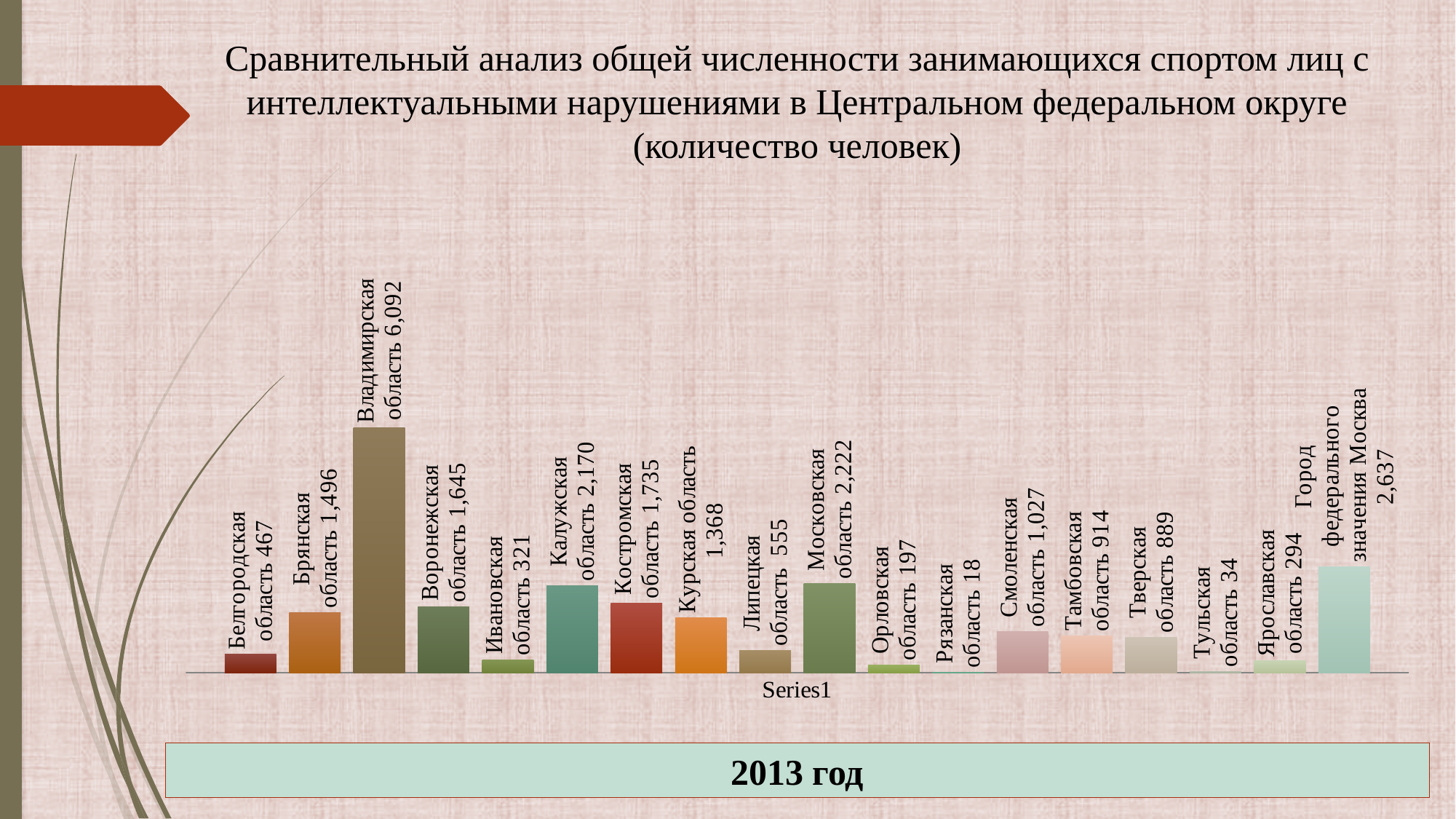
What is the difference between the values for Калужская область and Костромская область? 435 What is the value for Город федерального значения Москва? 2,637 What is the value for Тульская область? 34 What type of chart is shown on the slide? Bar chart What year is indicated in the box below the chart? 2013 год How many regions (categories) are plotted in the chart? 18 What is the value for Смоленская область? 1,027 Which region has the lowest value in the chart? Рязанская область What is the difference between the values for Город федерального значения Москва and Московская область? 415 Which is larger, the value for Воронежская область or Брянская область? Воронежская область What is the value for Владимирская область? 6,092 Which region has the highest value in the chart? Владимирская область